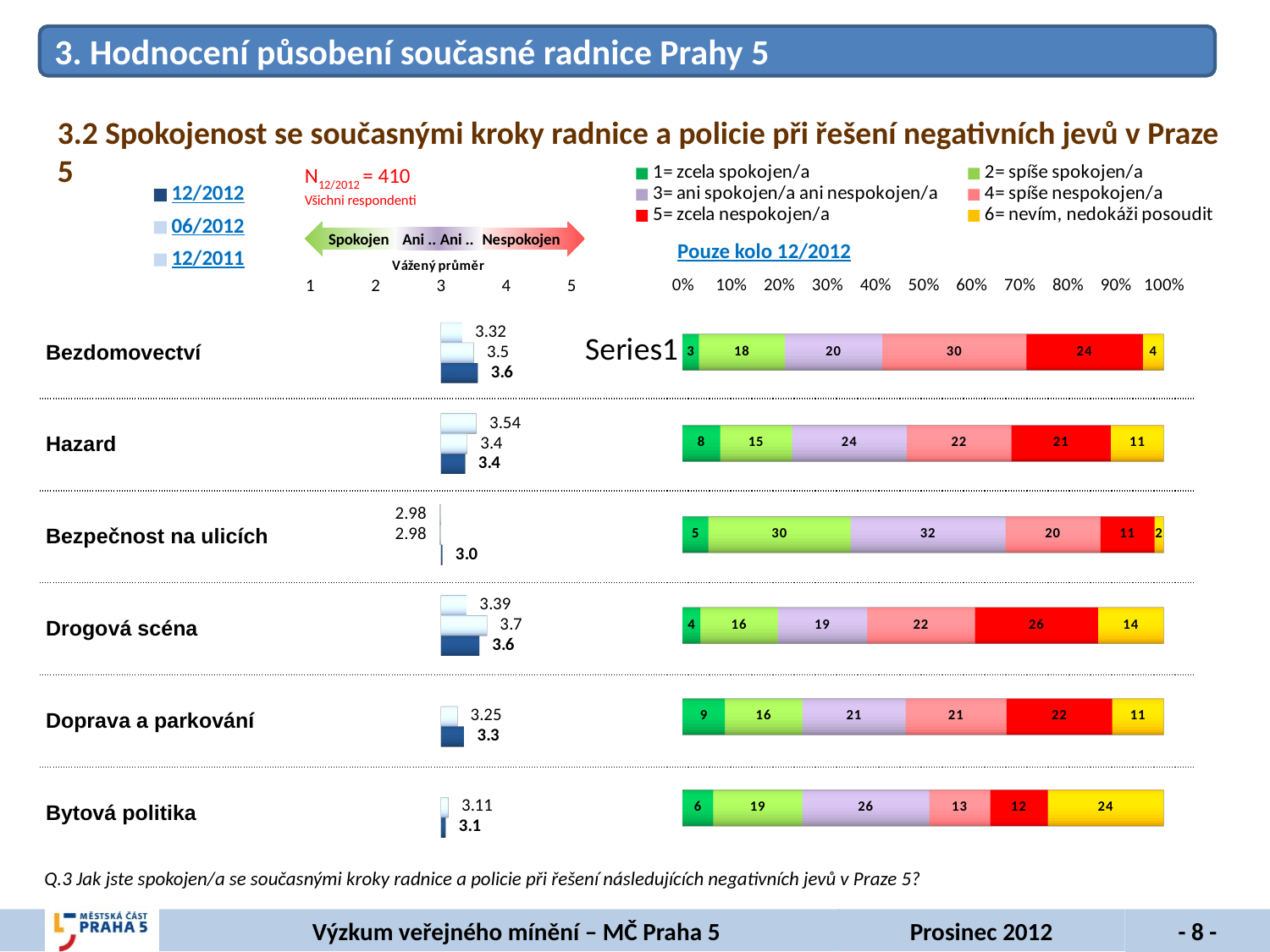
How many series does the legend of the stacked bar chart 'Pouze kolo 12/2012' list? 6 In the stacked bar chart 'Pouze kolo 12/2012', which category has the lowest value for '5= zcela nespokojen/a'? Bezpečnost na ulicích What kind of chart is the 'Pouze kolo 12/2012' chart on the right? stacked bar chart In the stacked bar chart 'Pouze kolo 12/2012', which category has the highest value for '1= zcela spokojen/a'? Doprava a parkování How many categories (negative phenomena) are shown on the slide's charts? 6 In the stacked bar chart 'Pouze kolo 12/2012', what is the value of '6= nevím, nedokáži posoudit' for Bytová politika? 24 In the 'Vážený průměr' chart on the left, what is the bold value shown for Bezpečnost na ulicích? 3.0 In the stacked bar chart 'Pouze kolo 12/2012', what is the value of '2= spíše spokojen/a' for Bezpečnost na ulicích? 30 How many series does the legend of the 'Vážený průměr' chart on the left list? 3 In the stacked bar chart 'Pouze kolo 12/2012', which is larger for Hazard: '3= ani spokojen/a ani nespokojen/a' or '4= spíše nespokojen/a'? 3= ani spokojen/a ani nespokojen/a In the stacked bar chart 'Pouze kolo 12/2012', what is the value of '5= zcela nespokojen/a' for Bezdomovectví? 24 In the stacked bar chart 'Pouze kolo 12/2012', what is the difference between the '3= ani spokojen/a ani nespokojen/a' values for Bezpečnost na ulicích and Drogová scéna? 13